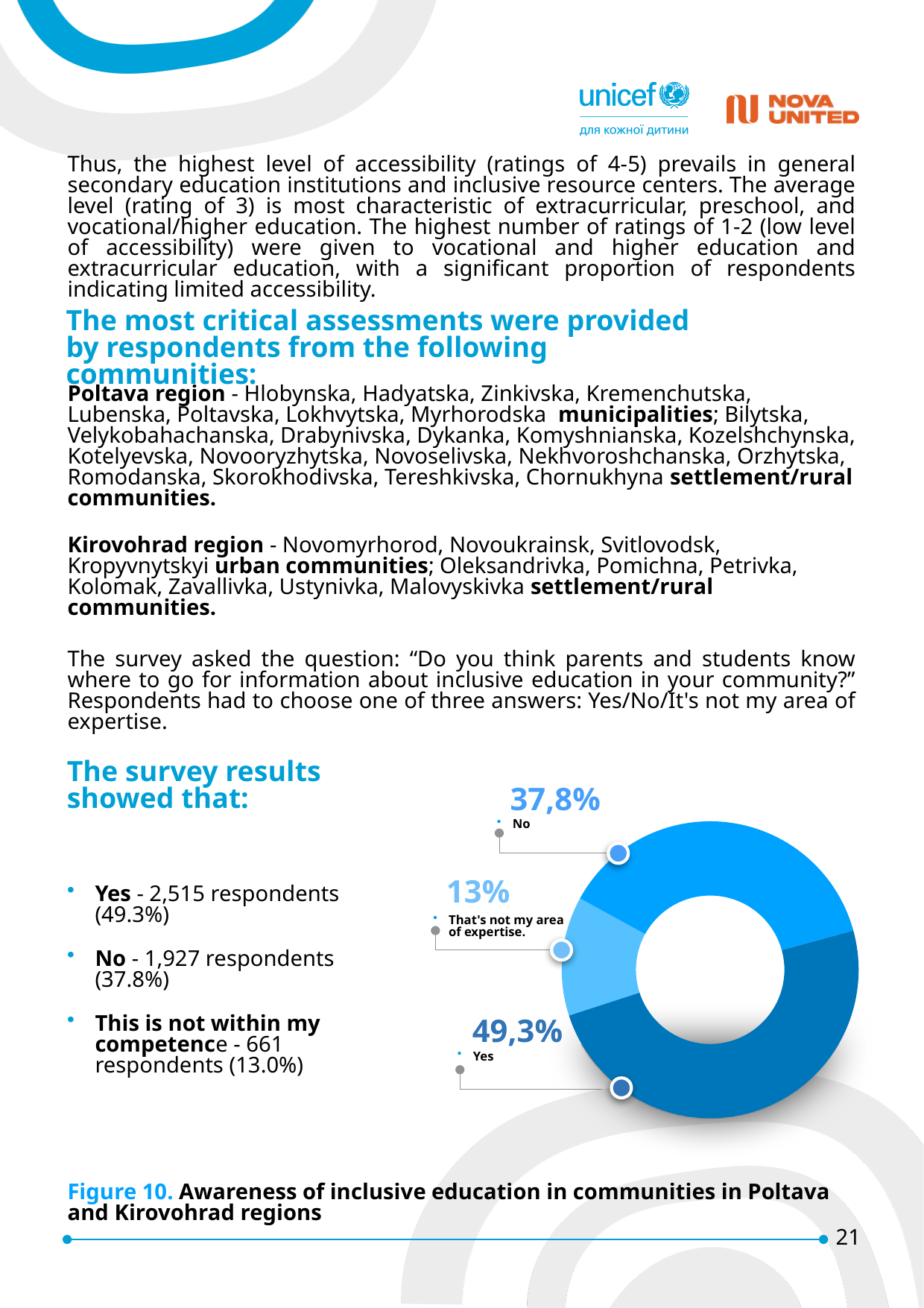
What is the difference in percentage points between the "Yes" and "No" slices in the pie chart? 11,5 What share of the pie chart is labelled "Yes"? 49,3% Which slice of the pie chart is the smallest? That's not my area of expertise How many slices does the pie chart have? 3 What kind of chart is shown on the slide? Pie chart (donut) What is the figure number and caption of the chart on the slide? Figure 10. Awareness of inclusive education in communities in Poltava and Kirovohrad regions What share of the pie chart is labelled "That's not my area of expertise"? 13% In the pie chart, which is larger: the "Yes" slice or the "No" slice? Yes Which slice of the pie chart is shown in the lightest blue colour? That's not my area of expertise What share of the pie chart is labelled "No"? 37,8% Which slice of the pie chart is the largest? Yes What is the difference in percentage points between the "No" slice and the "That's not my area of expertise" slice in the pie chart? 24,8